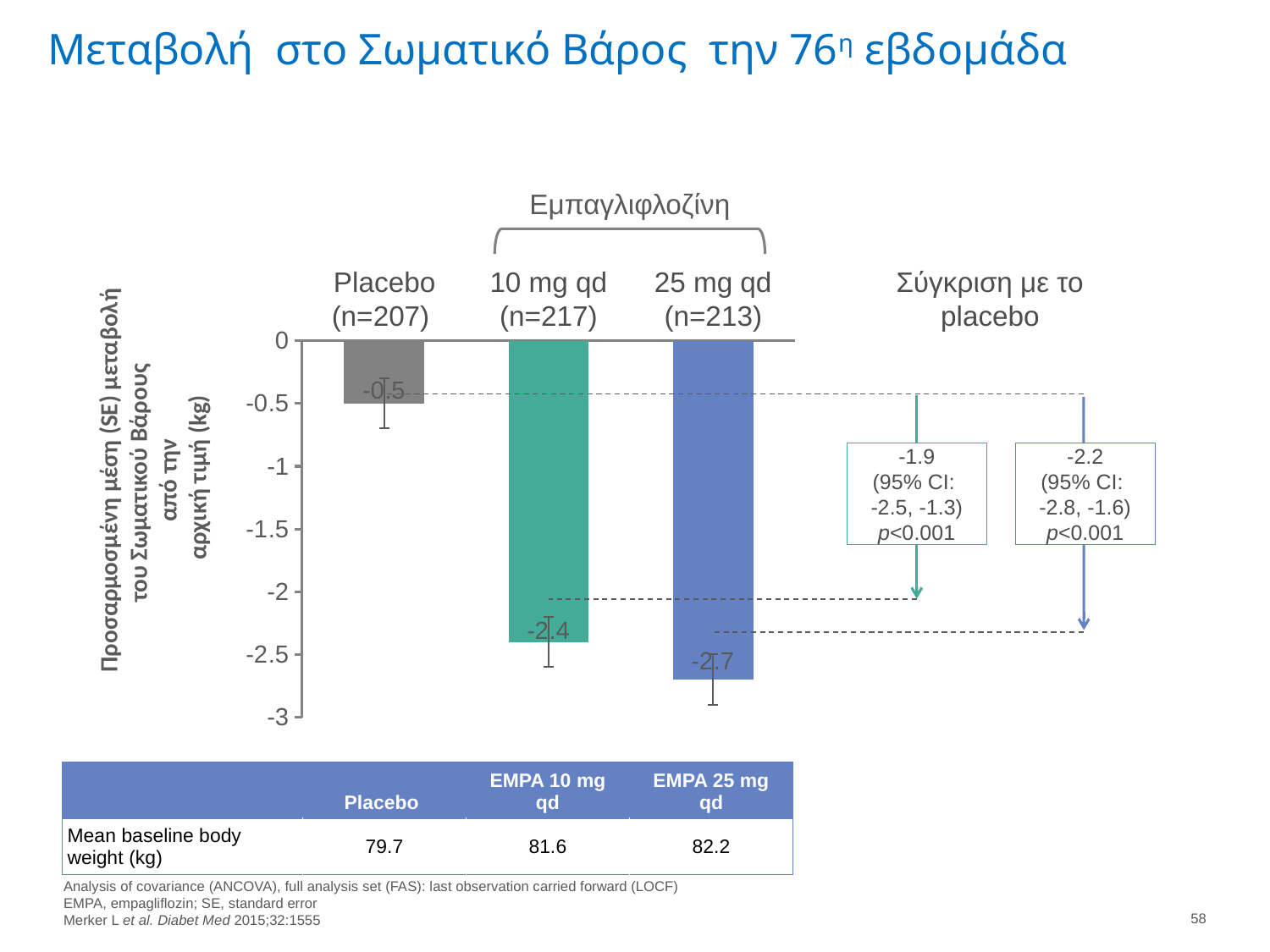
What is the adjusted mean change in body weight for the Placebo group? -0.5 What is the difference between the body weight change for 25 mg qd and for Placebo? -2.2 What kind of chart is shown on the slide? bar chart What is the adjusted mean change in body weight for the 25 mg qd empagliflozin group? -2.7 Which group shows the largest reduction in body weight? 25 mg qd How many treatment groups are plotted as bars in the chart? 3 Which group shows the smallest change in body weight? Placebo What is the adjusted mean change in body weight for the 10 mg qd empagliflozin group? -2.4 Which group has a larger reduction in body weight, 10 mg qd or Placebo? 10 mg qd What is the number of patients (n) in the Placebo group shown above the chart? 207 What is the difference between the body weight change for 25 mg qd and for 10 mg qd? 0.3 Is the value for 25 mg qd greater or less than -2? less